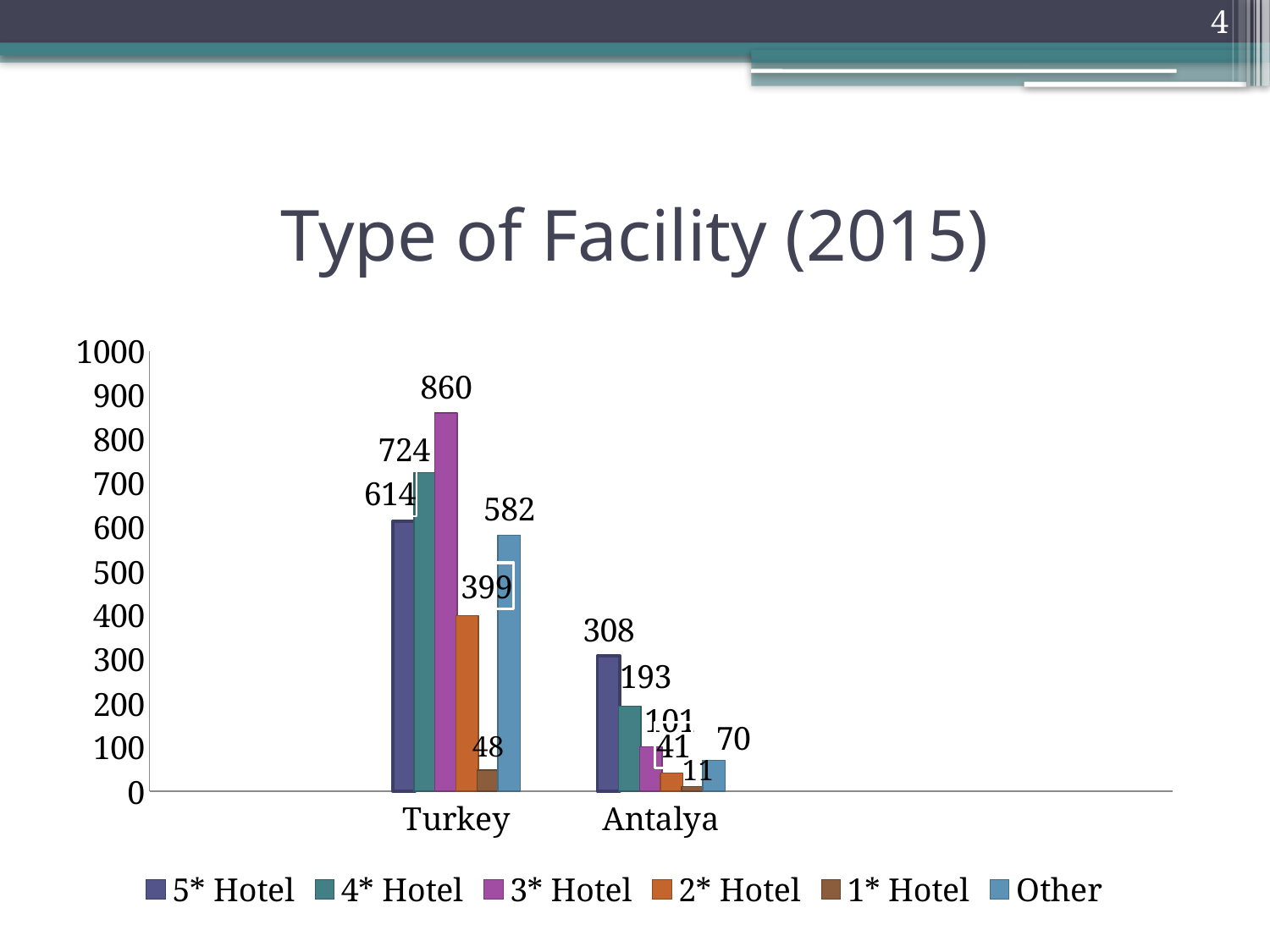
What is the value for Other in Turkey? 582 Which is larger in Turkey: 5* Hotel or Other? 5* Hotel How many series does the legend list? 6 What is the value for 5* Hotel in Antalya? 308 What is the value for 3* Hotel in Turkey? 860 What is the difference between the 4* Hotel values for Turkey and Antalya? 531 What kind of chart is shown on the slide? Bar chart Which type of facility has the lowest value in Antalya? 1* Hotel Which type of facility has the highest value in Turkey? 3* Hotel What is the title of the chart? Type of Facility (2015) What is the value for 1* Hotel in Antalya? 11 How many categories are shown on the x axis? 2